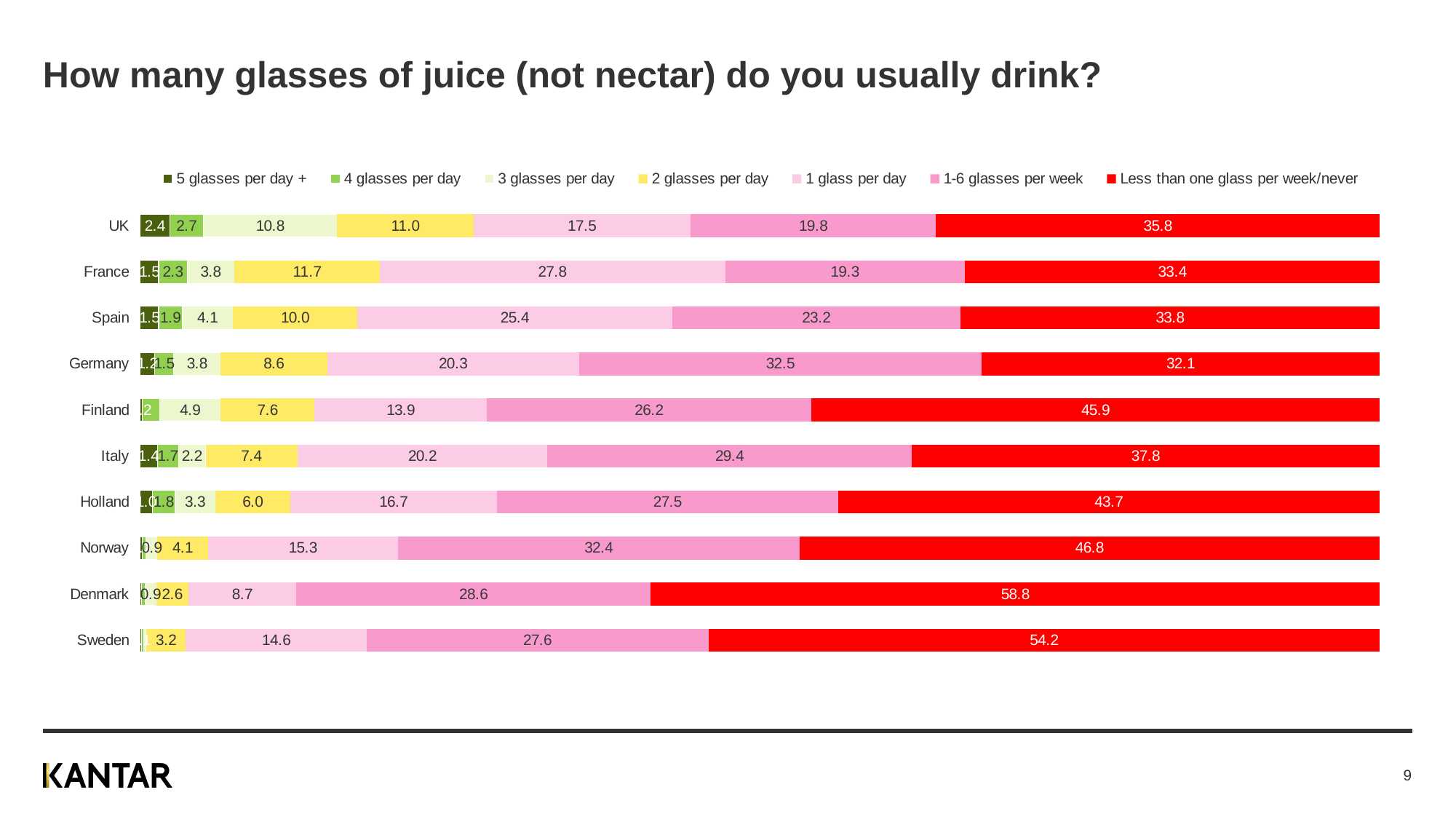
Which series is shown in red in the chart? Less than one glass per week/never What is the value for '1 glass per day' for France? 27.8 How many series does the legend list? 7 Which is larger: the '1-6 glasses per week' value for Italy or for Holland? Italy Which country has the highest value for 'Less than one glass per week/never'? Denmark Which country has the lowest value for 'Less than one glass per week/never'? Germany What is the value for '2 glasses per day' for the UK? 11.0 What is the difference between the 'Less than one glass per week/never' values for Denmark and Sweden? 4.6 Which country has the highest value for '1 glass per day'? France What kind of chart is shown on the slide? Stacked bar chart How many countries are shown in the chart? 10 What is the value for 'Less than one glass per week/never' for Denmark? 58.8